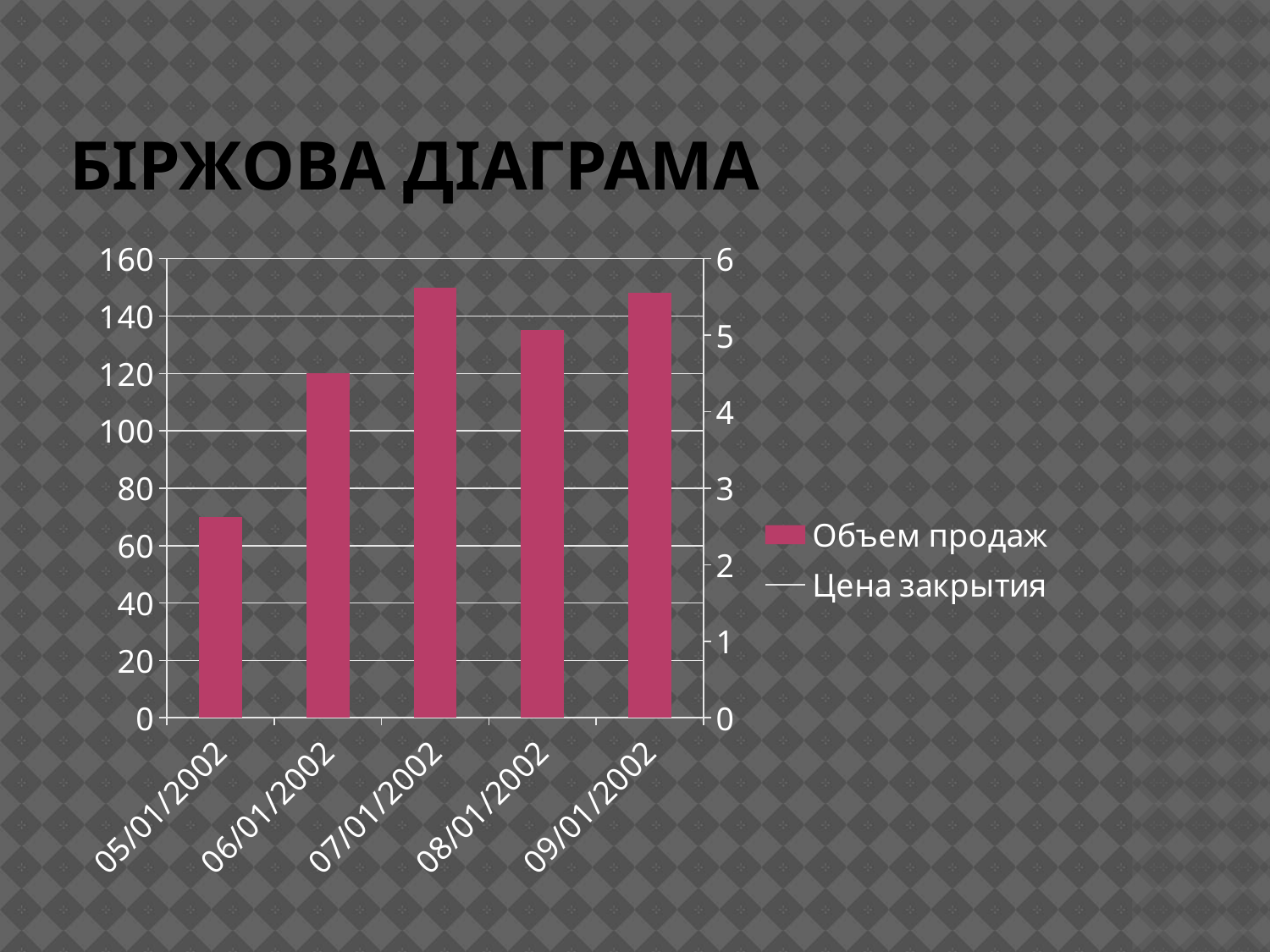
What kind of chart is shown on the slide? bar chart What is the title of the slide? БІРЖОВА ДІАГРАМА Is the Объем продаж value for 07/01/2002 greater or less than 140? greater Is the Объем продаж value for 05/01/2002 greater or less than 80? less Which has a larger Объем продаж, 06/01/2002 or 08/01/2002? 08/01/2002 Which date has the lowest Объем продаж? 05/01/2002 Is the Объем продаж value for 08/01/2002 greater or less than 120? greater How many dates are shown on the x axis? 5 How many series does the legend list? 2 Which has a larger Объем продаж, 05/01/2002 or 09/01/2002? 09/01/2002 What is the value of Объем продаж for 06/01/2002? 120